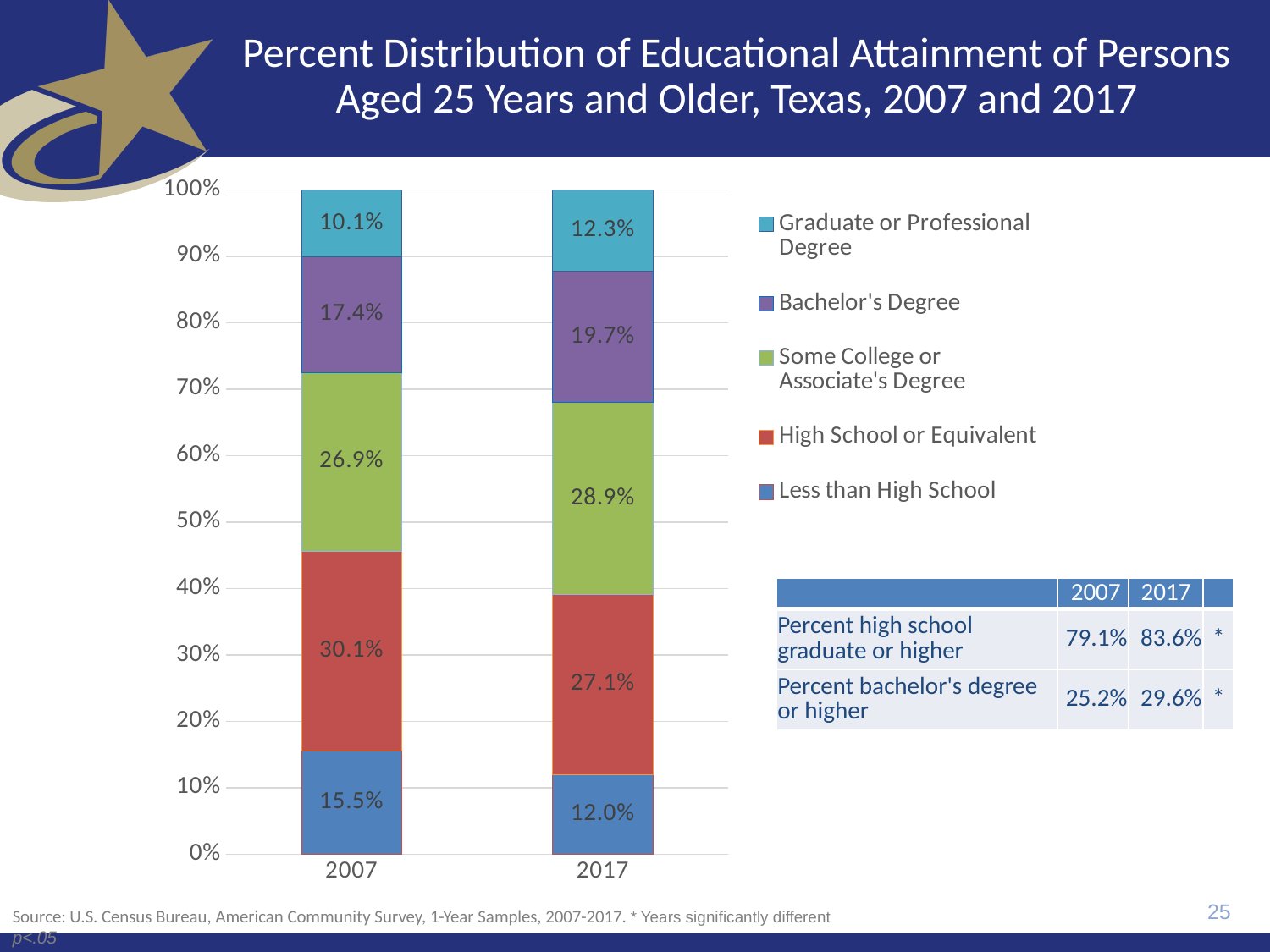
How many series does the legend list? 5 Which year had a larger share of Some College or Associate's Degree, 2007 or 2017? 2017 What was the share for High School or Equivalent in 2017? 27.1% How many years (categories) are shown on the x axis? 2 Which educational attainment category had the largest share in 2017? Some College or Associate's Degree What percentage had Less than High School education in 2007? 15.5% What percentage of persons aged 25 and older in Texas had a Bachelor's Degree in 2017? 19.7% What percentage had a Graduate or Professional Degree in 2007? 10.1% Which educational attainment category had the smallest share in 2007? Graduate or Professional Degree By how many percentage points did the Less than High School share change from 2007 to 2017? 3.5 percentage points lower Did the share of persons with a Graduate or Professional Degree rise or fall from 2007 to 2017? Rise What kind of chart is shown on the slide? Stacked bar chart